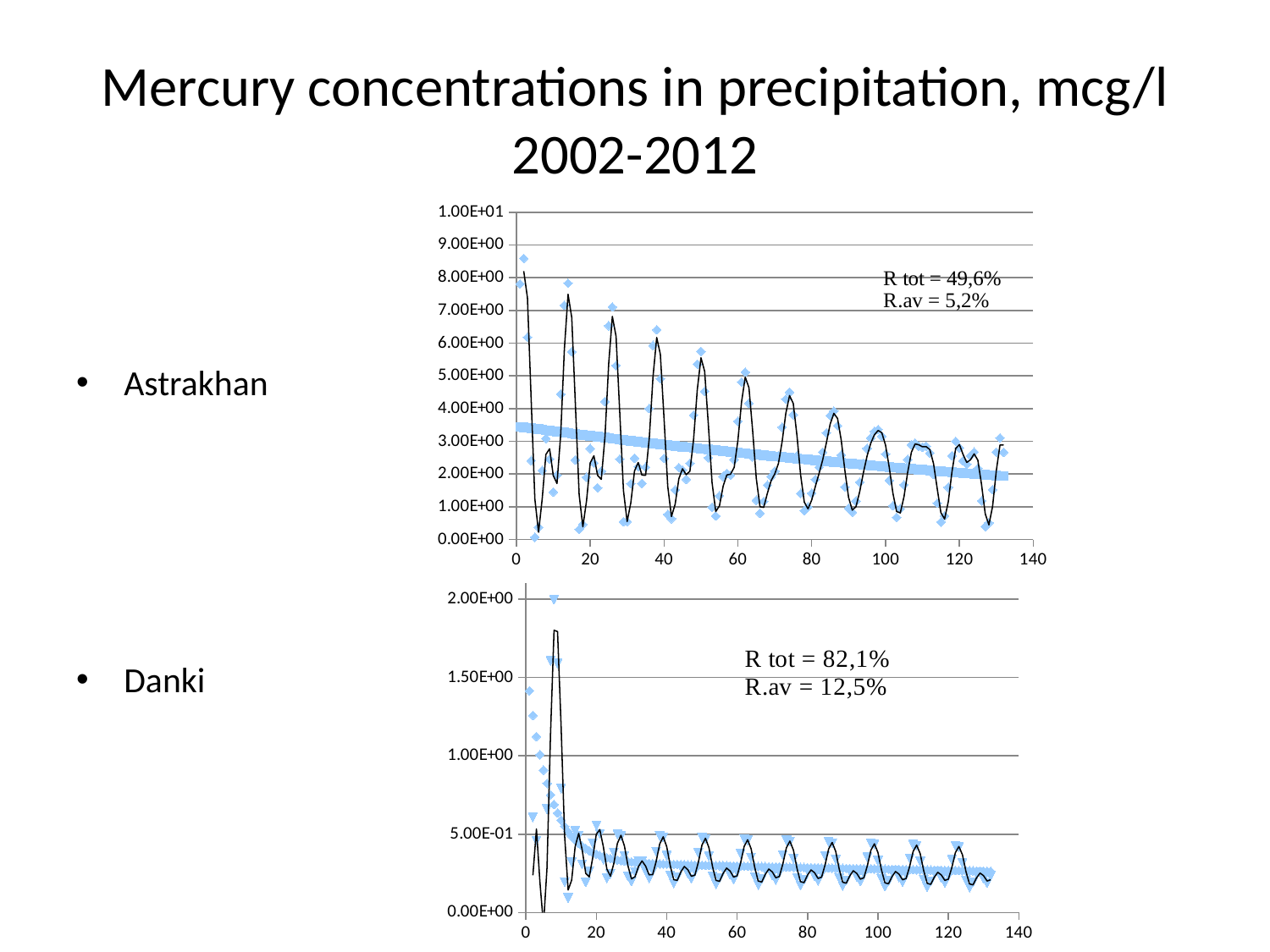
In the Danki chart (bottom), do the plotted values overall rise or fall from the start of the x axis to the end? fall In the Astrakhan chart (top), is the highest plotted point greater or less than 8.00E+00? greater What R.av value is annotated on the Danki chart (bottom)? 12,5% In the Astrakhan chart (top), is the trend line value at x = 0 greater or less than 3.00E+00? greater In the Danki chart (bottom), are the plotted values beyond x = 40 greater or less than 1.00E+00? less How many charts are shown on the slide? 2 What R tot value is annotated on the Astrakhan chart (top)? 49,6% What kind of chart is the Astrakhan chart (top chart)? scatter chart In the Astrakhan chart (top), does the straight trend line rise or fall as the x axis increases from 0 to 140? falls